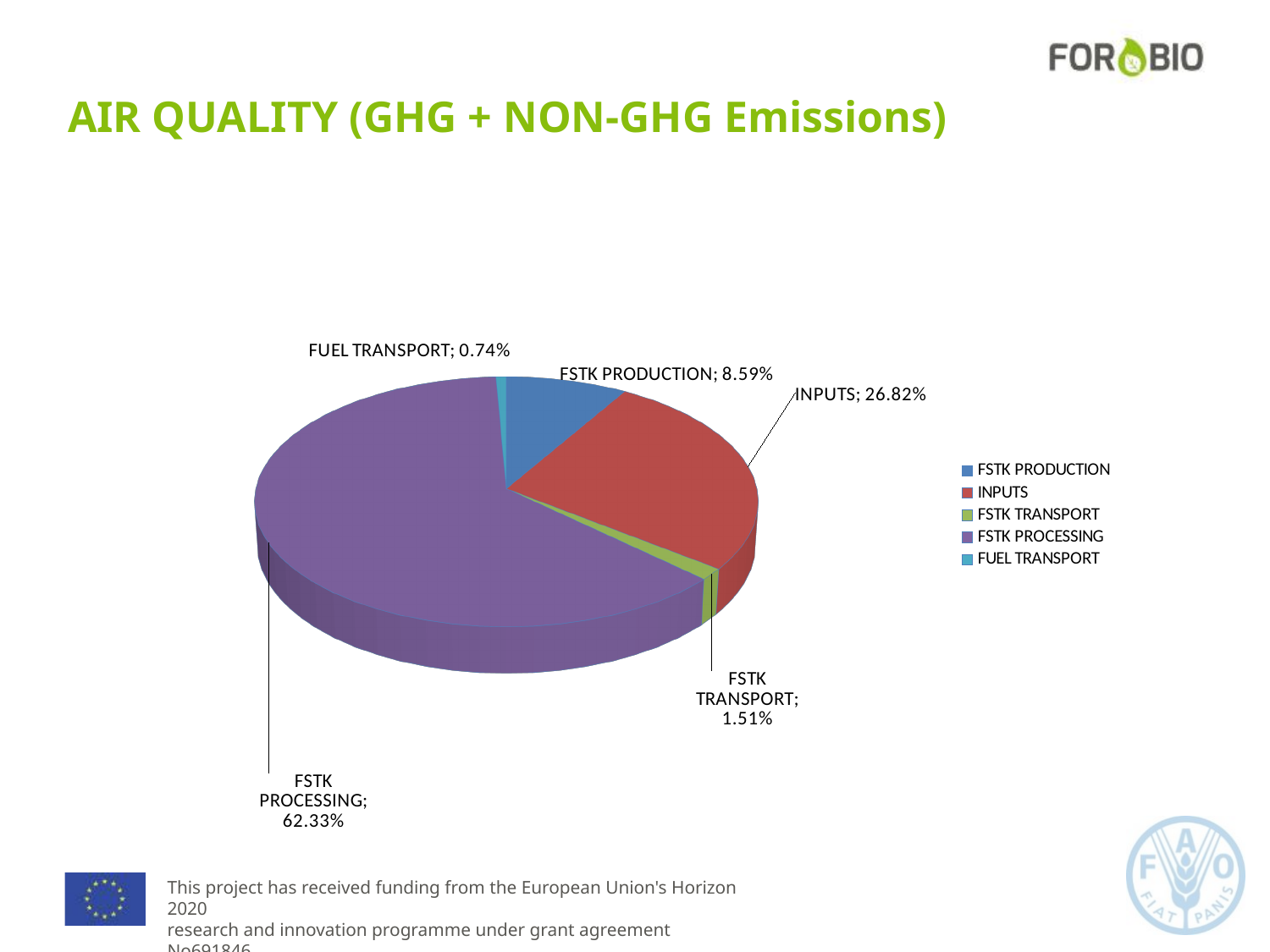
How many slices does the pie chart have? 5 What share of the pie does FSTK PROCESSING account for? 62.33% What is the difference between the FSTK PROCESSING share and the INPUTS share? 35.51% What is the value shown for INPUTS? 26.82% What is the value for FSTK TRANSPORT? 1.51% What is the difference between the INPUTS share and the FSTK PRODUCTION share? 18.23% What colour is the FSTK PROCESSING slice in the legend? Purple Which is larger, FSTK PRODUCTION or FSTK TRANSPORT? FSTK PRODUCTION What percentage is labelled for FUEL TRANSPORT? 0.74% What type of chart is shown on the slide? Pie chart Which category has the smallest slice of the pie? FUEL TRANSPORT Which category has the largest slice of the pie? FSTK PROCESSING